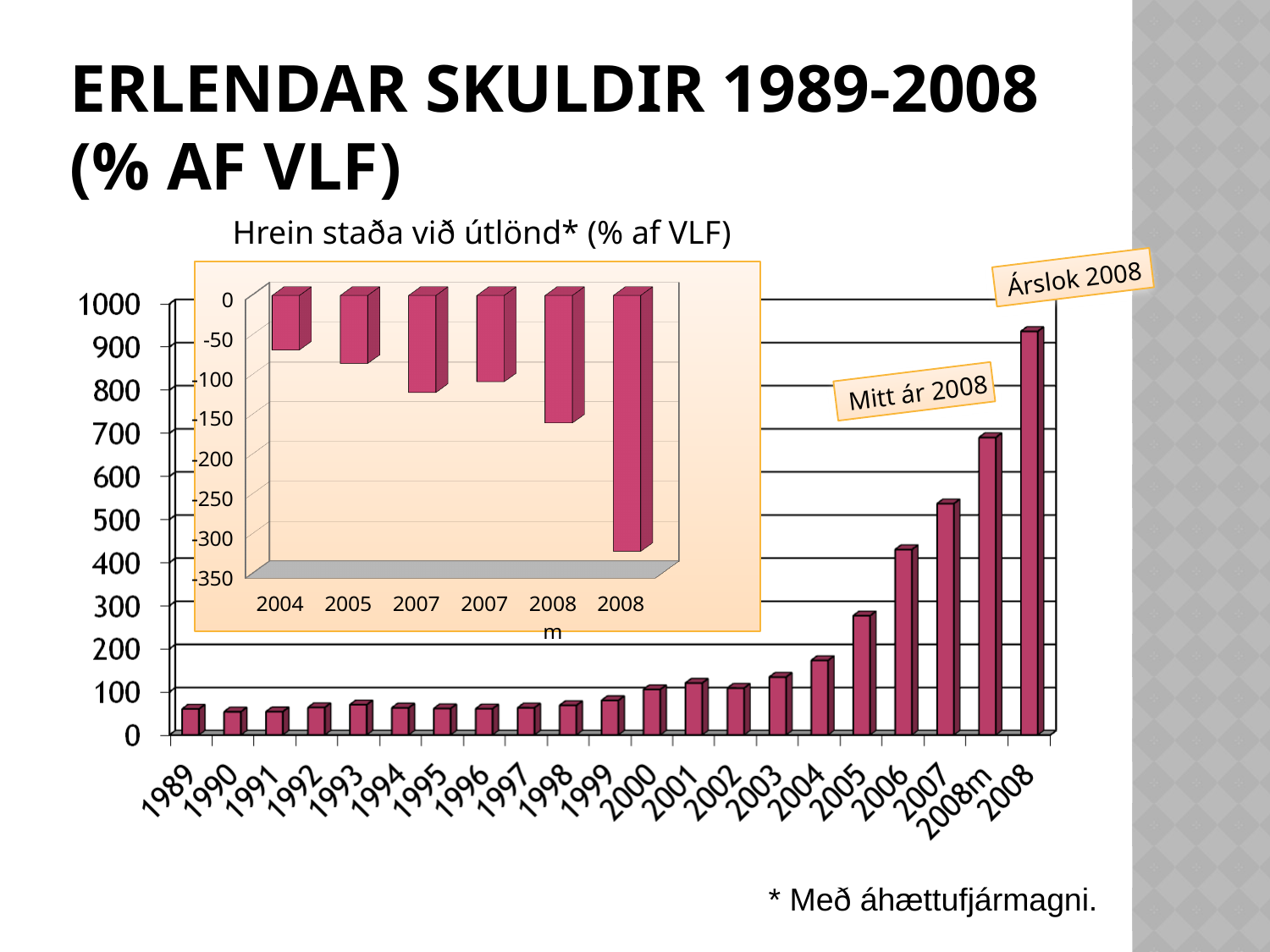
In the inset chart 'Hrein staða við útlönd* (% af VLF)', is the value for 2008m greater or less than -300? greater In the main chart, is the value for 2007 greater or less than 500? greater In the main chart, is the value for 1989 greater or less than 100? less In the main chart, do the values generally rise or fall from 1989 to 2008? rise What kind of chart is the main chart on the slide? bar chart In the inset chart 'Hrein staða við útlönd* (% af VLF)', which category has the lowest value? 2008 In the inset chart 'Hrein staða við útlönd* (% af VLF)', how many bars are shown? 6 In the main chart, which year has the highest value? 2008 In the main chart, which is larger, the value for 2006 or the value for 2007? 2007 In the main chart, how many categories are shown on the x axis? 21